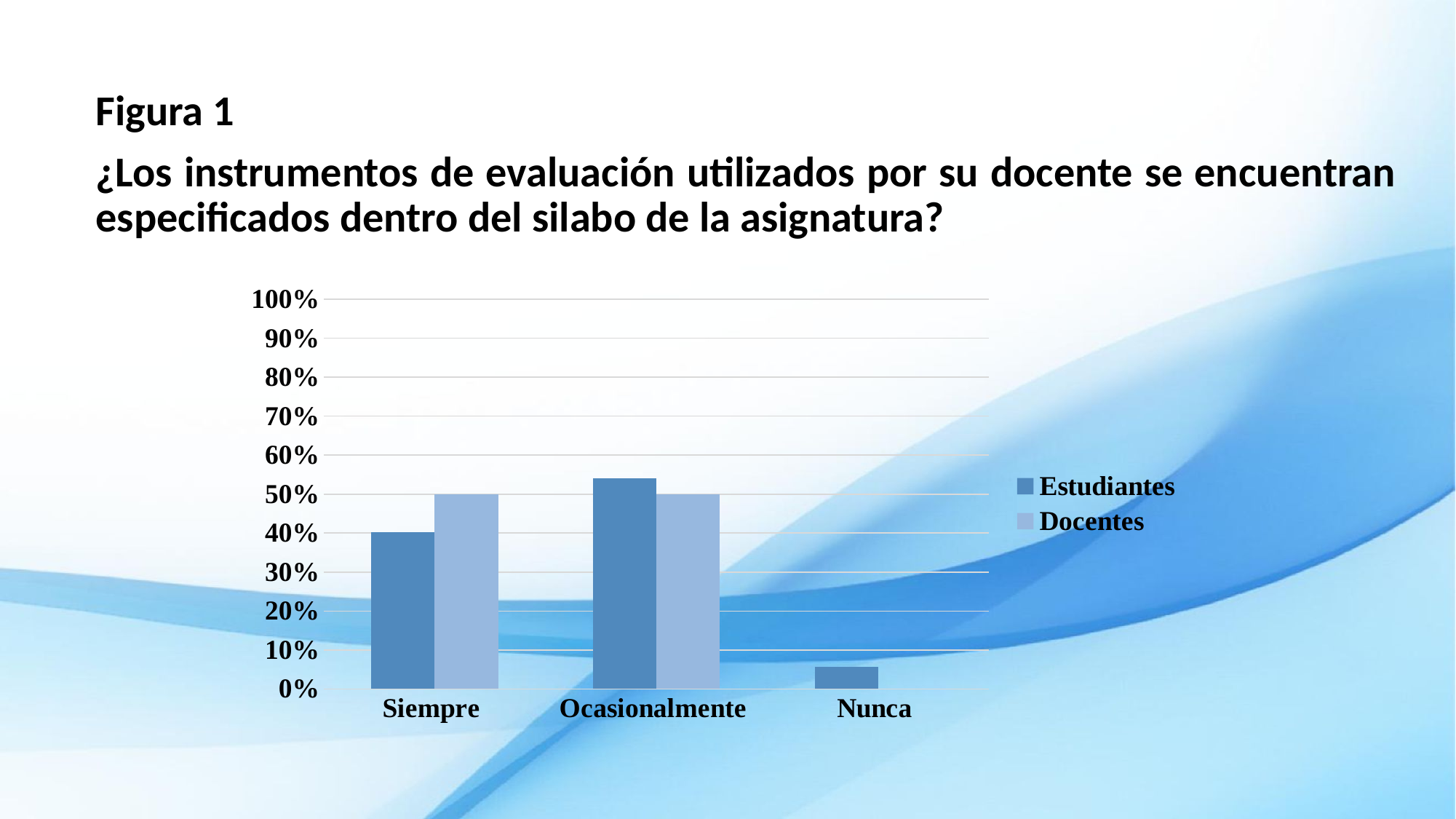
Which category has the lowest value for Estudiantes? Nunca What is the value for Docentes in the Siempre category? 50% What type of chart is shown on the slide? Bar chart How many categories are shown on the x axis? 3 Is the value for Estudiantes in the Nunca category greater or less than 10%? less In the Siempre category, which series has the larger value, Estudiantes or Docentes? Docentes Is the value for Estudiantes in the Ocasionalmente category greater or less than 50%? greater What is the value for Docentes in the Ocasionalmente category? 50% How many series does the legend list? 2 Which category has the highest value for Estudiantes? Ocasionalmente